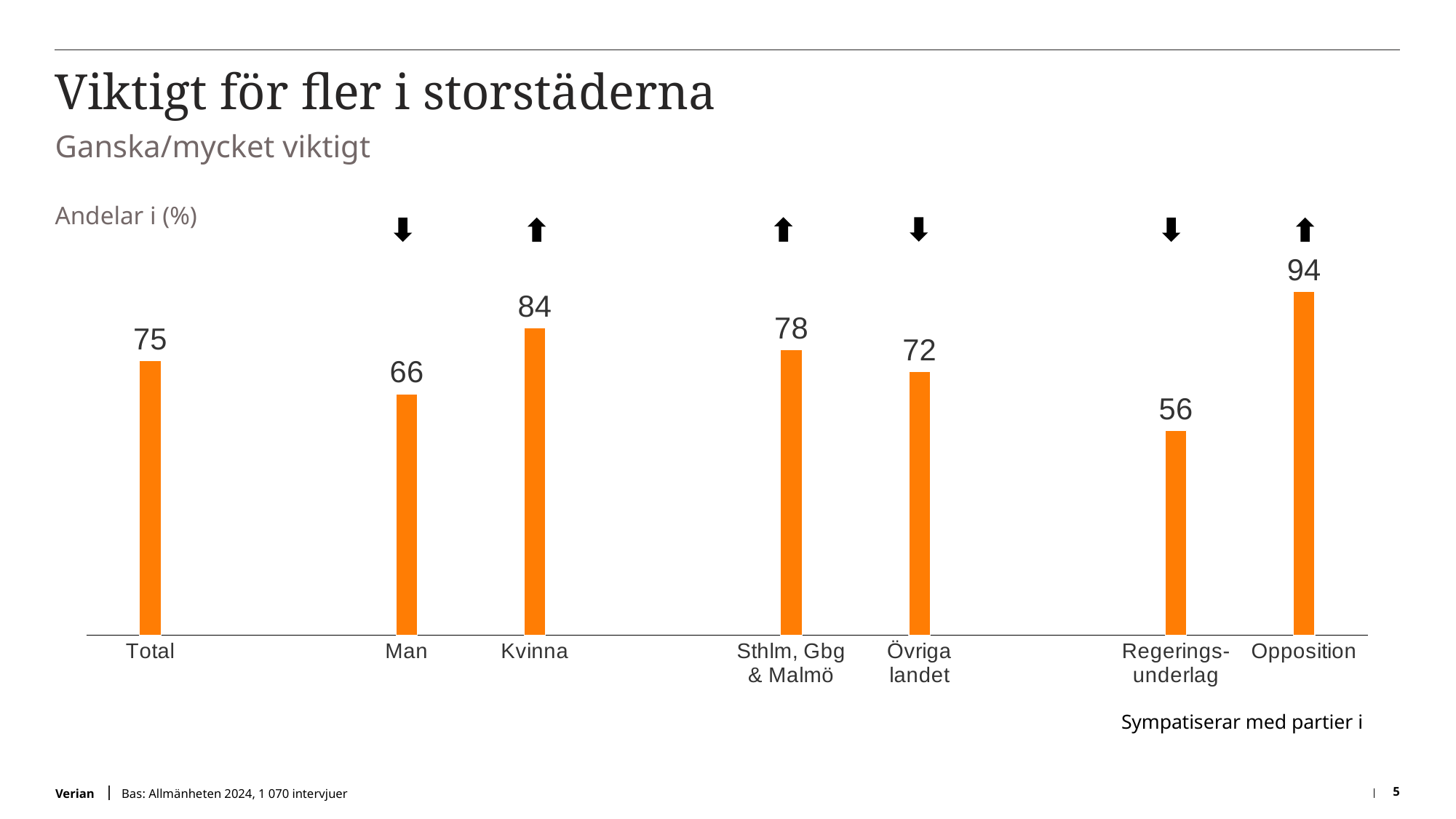
Which is larger, the value for Opposition or the value for Regerings-underlag? Opposition Which category has the highest value? Opposition What is the value for Kvinna? 84 What is the value for Regerings-underlag? 56 What is the difference between the values for Kvinna and Man? 18 Which category has the lowest value? Regerings-underlag What is the value for Sthlm, Gbg & Malmö? 78 What is the difference between the values for Sthlm, Gbg & Malmö and Övriga landet? 6 What is the title of the slide? Viktigt för fler i storstäderna How many categories are shown in the chart? 7 What is the value for Total? 75 What kind of chart is shown on the slide? Bar chart